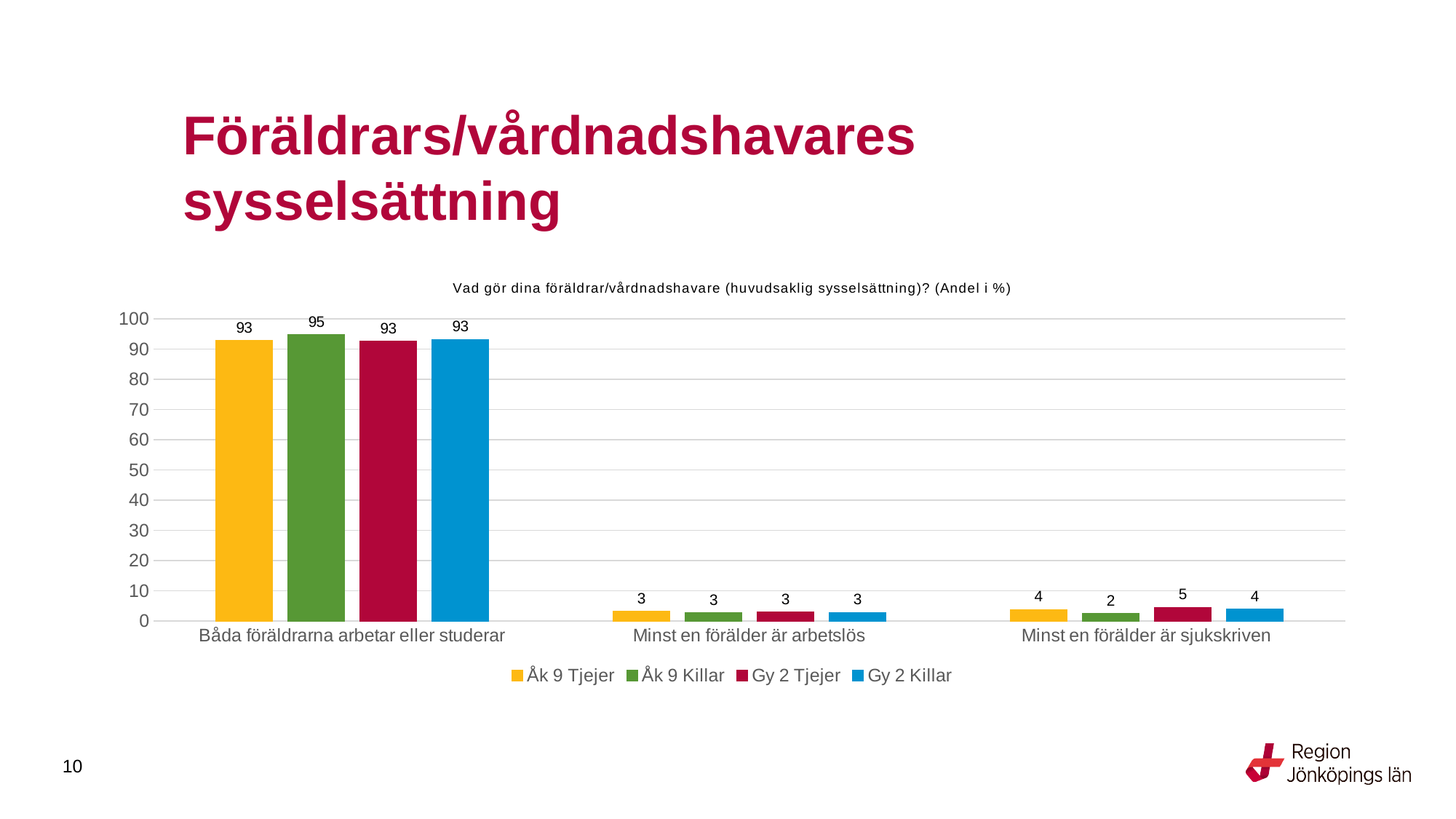
What is the value for Gy 2 Tjejer in the category 'Minst en förälder är sjukskriven'? 5 How many categories are shown on the x axis? 3 What is the difference between the Gy 2 Tjejer value and the Åk 9 Killar value in the category 'Minst en förälder är sjukskriven'? 3 Which series has the highest value in the category 'Båda föräldrarna arbetar eller studerar'? Åk 9 Killar What kind of chart is shown on the slide? Bar chart How many series does the legend list? 4 What is the value for Gy 2 Killar in the category 'Minst en förälder är arbetslös'? 3 Which series has the lowest value in the category 'Minst en förälder är sjukskriven'? Åk 9 Killar What is the value for Åk 9 Killar in the category 'Minst en förälder är sjukskriven'? 2 What is the difference between the Åk 9 Killar value and the Åk 9 Tjejer value in the category 'Båda föräldrarna arbetar eller studerar'? 2 Which is larger: the Gy 2 Tjejer value or the Gy 2 Killar value in the category 'Minst en förälder är sjukskriven'? Gy 2 Tjejer What is the value for Åk 9 Killar in the category 'Båda föräldrarna arbetar eller studerar'? 95